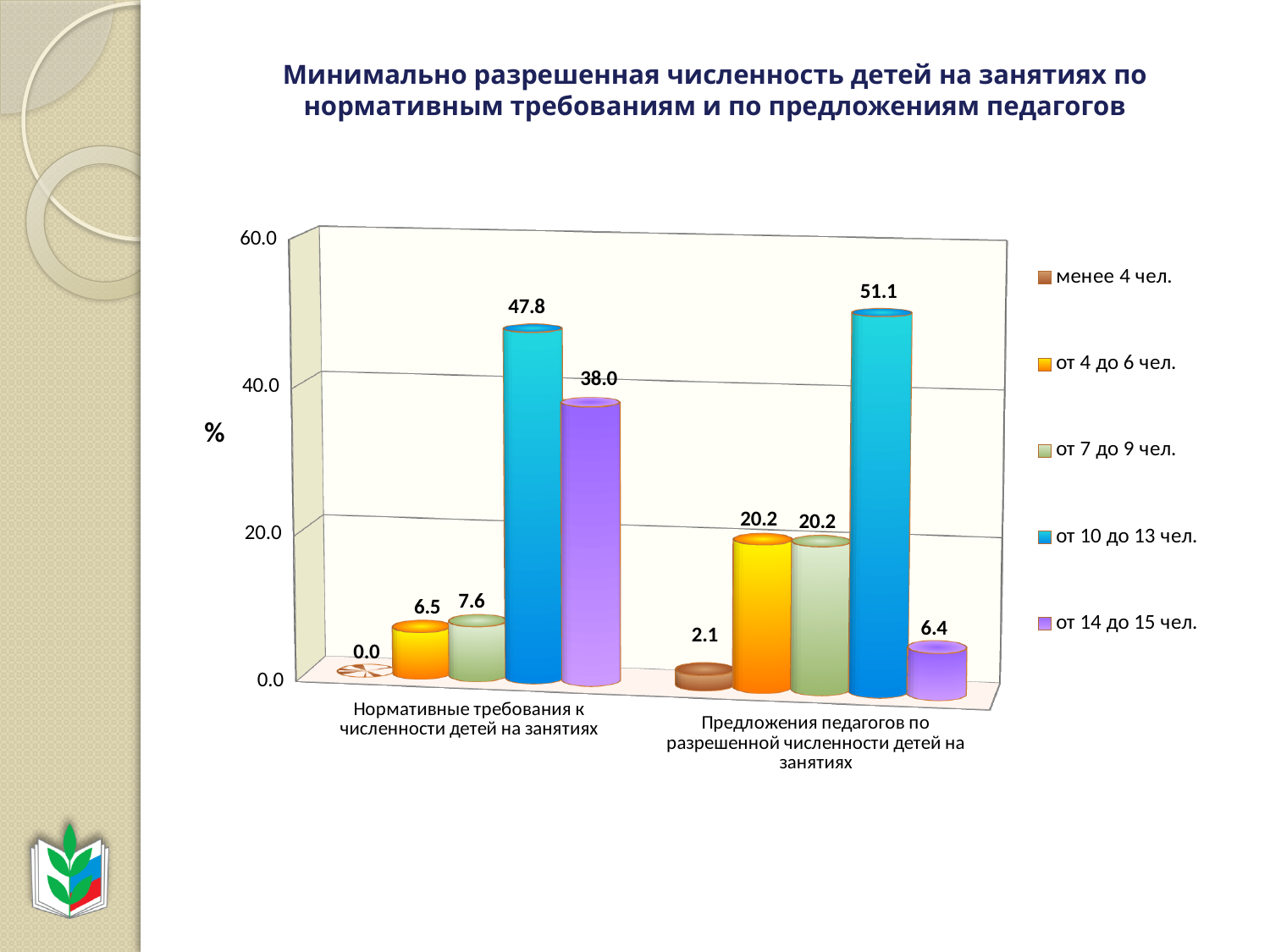
What is the value for 'от 14 до 15 чел.' in the category 'Предложения педагогов по разрешенной численности детей на занятиях'? 6.4 Which is larger: the 'от 14 до 15 чел.' value for 'Нормативные требования к численности детей на занятиях' or for 'Предложения педагогов по разрешенной численности детей на занятиях'? Нормативные требования к численности детей на занятиях Which series has the highest value in the category 'Предложения педагогов по разрешенной численности детей на занятиях'? от 10 до 13 чел. Is the value for 'от 10 до 13 чел.' in the category 'Предложения педагогов по разрешенной численности детей на занятиях' greater or less than 40.0? greater How many categories are shown on the x axis of the chart? 2 What is the value for 'менее 4 чел.' in the category 'Предложения педагогов по разрешенной численности детей на занятиях'? 2.1 What unit label is shown on the vertical axis of the chart? % What is the value for 'от 10 до 13 чел.' in the category 'Нормативные требования к численности детей на занятиях'? 47.8 Which series has the lowest value in the category 'Нормативные требования к численности детей на занятиях'? менее 4 чел. What is the difference between the 'от 10 до 13 чел.' value and the 'от 14 до 15 чел.' value in the category 'Нормативные требования к численности детей на занятиях'? 9.8 How many series does the legend list? 5 What kind of chart is shown on the slide? bar chart